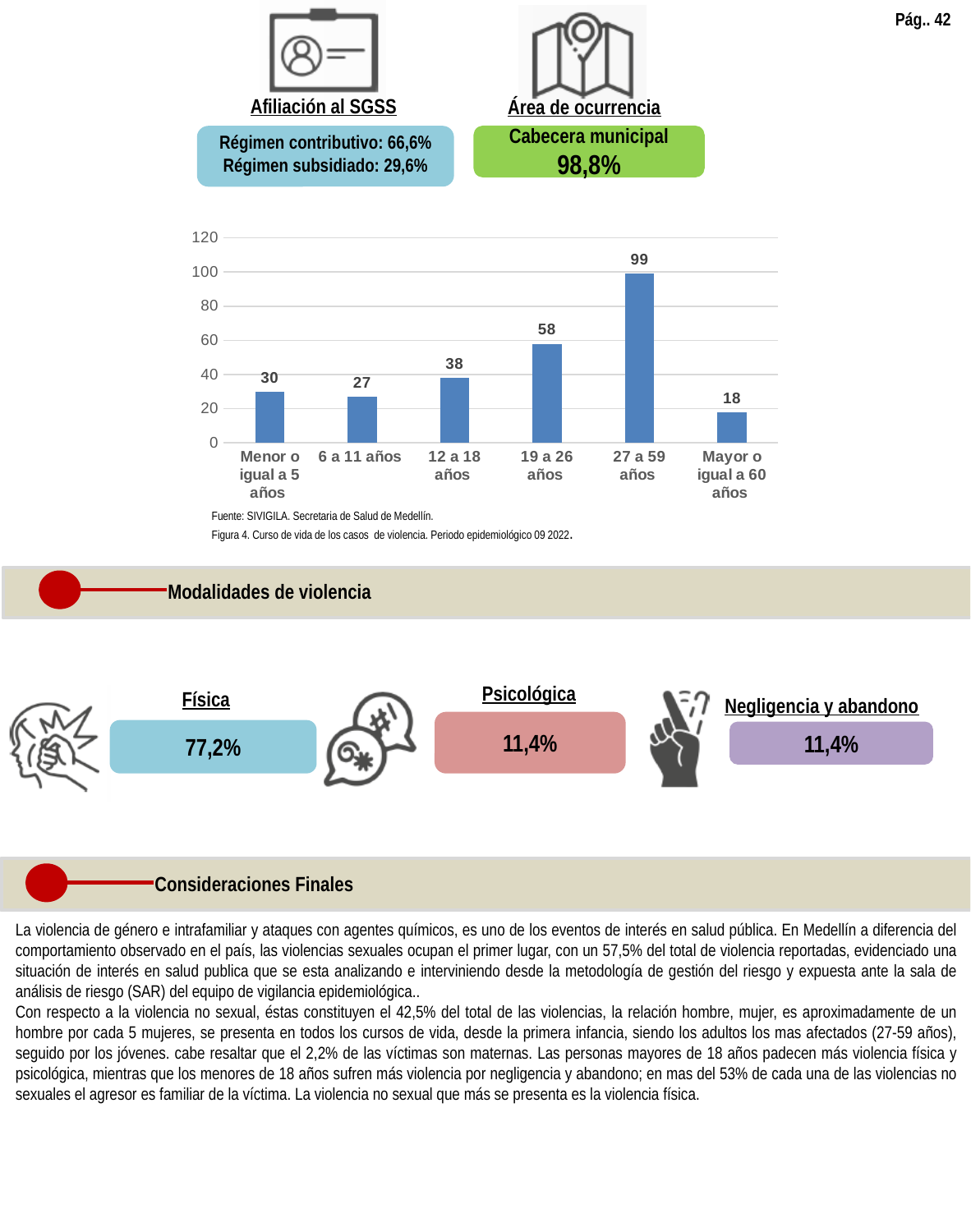
Which age group has the lowest value? Mayor o igual a 60 años What kind of chart is shown on the slide? bar chart How many age-group categories are shown on the x axis? 6 What is the difference between the values for '27 a 59 años' and '19 a 26 años'? 41 What is the value for the 'Menor o igual a 5 años' category? 30 Which age group has the highest value? 27 a 59 años Is the value for '19 a 26 años' greater or less than 40? greater What is the source cited below the chart? SIVIGILA. Secretaria de Salud de Medellín. What is the value for the '27 a 59 años' category? 99 What is the difference between the values for '12 a 18 años' and '6 a 11 años'? 11 Which is larger, the value for 'Menor o igual a 5 años' or the value for 'Mayor o igual a 60 años'? Menor o igual a 5 años What is the value for the '19 a 26 años' category? 58